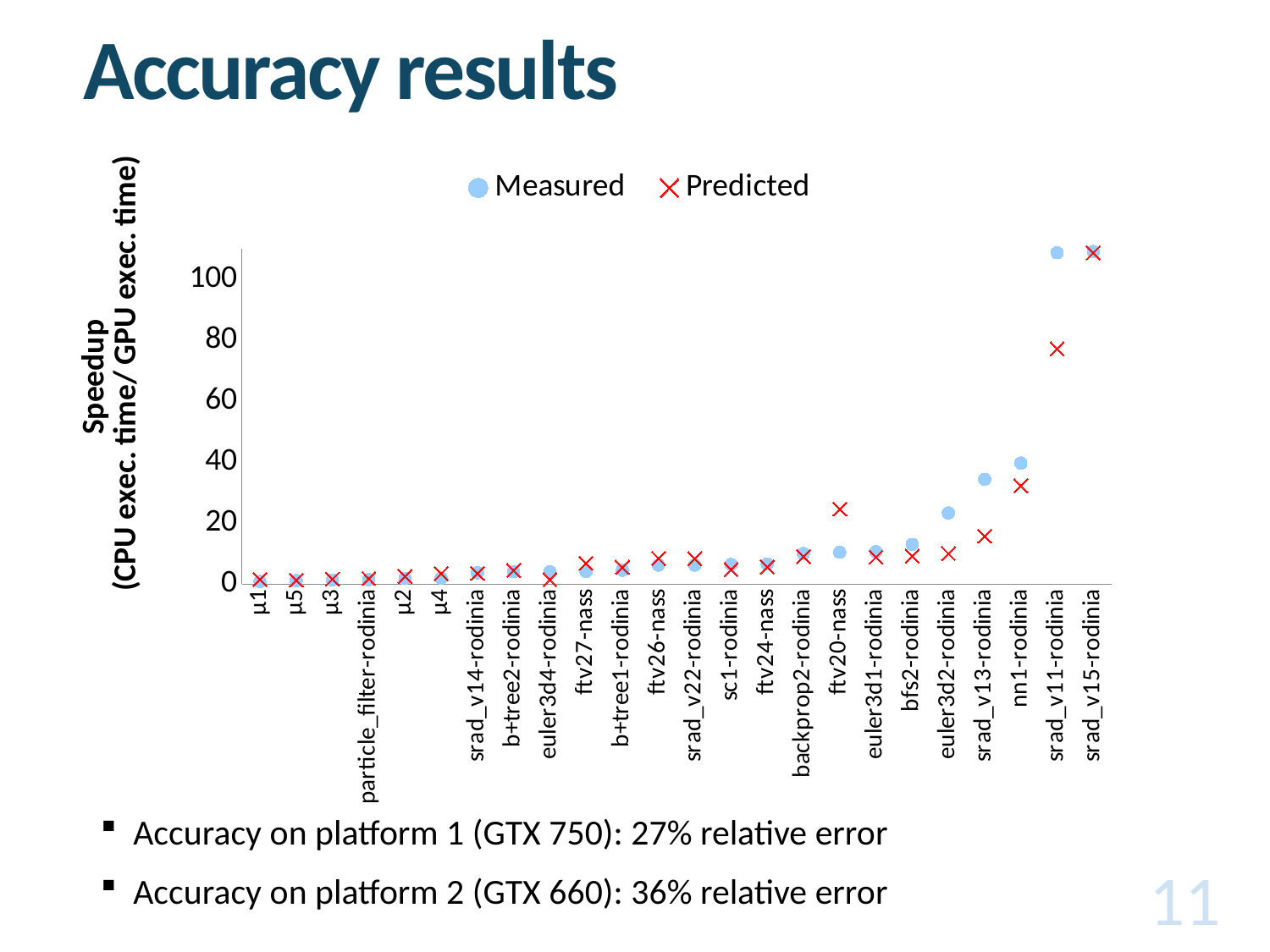
Which category has the highest Predicted speedup? srad_v15-rodinia How many series does the legend list? 2 Is the Predicted value for srad_v11-rodinia greater or less than 60? greater For ftv20-nass, which is larger: the Measured or the Predicted speedup? Predicted Is the Predicted value for euler3d2-rodinia greater or less than 20? less Do the Measured speedup values generally rise or fall from left to right along the x axis? rise For nn1-rodinia, which is larger: the Measured or the Predicted speedup? Measured What marker symbol is used for the Predicted series in the legend? red X Is the Measured value for nn1-rodinia greater or less than 20? greater How many benchmarks (categories) are plotted along the x axis? 24 What kind of chart is shown on the slide? scatter chart